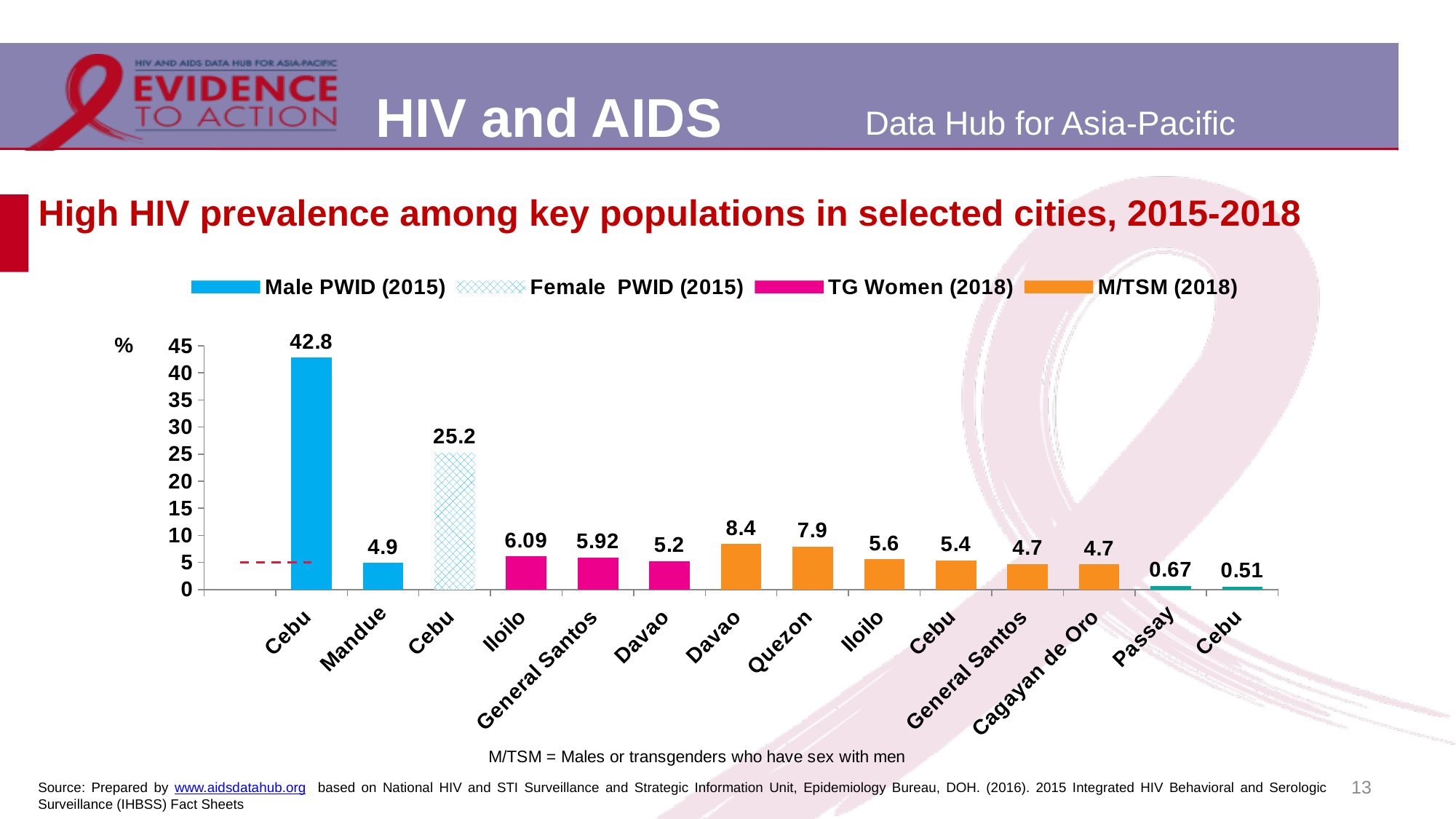
Which is larger: the M/TSM (2018) value for Davao or the TG Women (2018) value for Davao? M/TSM (2018) value for Davao What is the HIV prevalence among TG Women (2018) in Iloilo? 6.09 What is the HIV prevalence among Female PWID (2015) in Cebu? 25.2 What is the HIV prevalence among M/TSM (2018) in Quezon? 7.9 What kind of chart is shown on the slide? Bar chart Which bar shows the highest HIV prevalence on the chart? Cebu, Male PWID (2015) How many bars are plotted on the chart? 14 What is the difference between the Male PWID (2015) value for Cebu and the Female PWID (2015) value for Cebu? 17.6 What is the HIV prevalence among Male PWID (2015) in Cebu? 42.8 How many series does the legend list? 4 What is the maximum value shown on the vertical axis? 45 Which city has the highest HIV prevalence among M/TSM (2018)? Davao